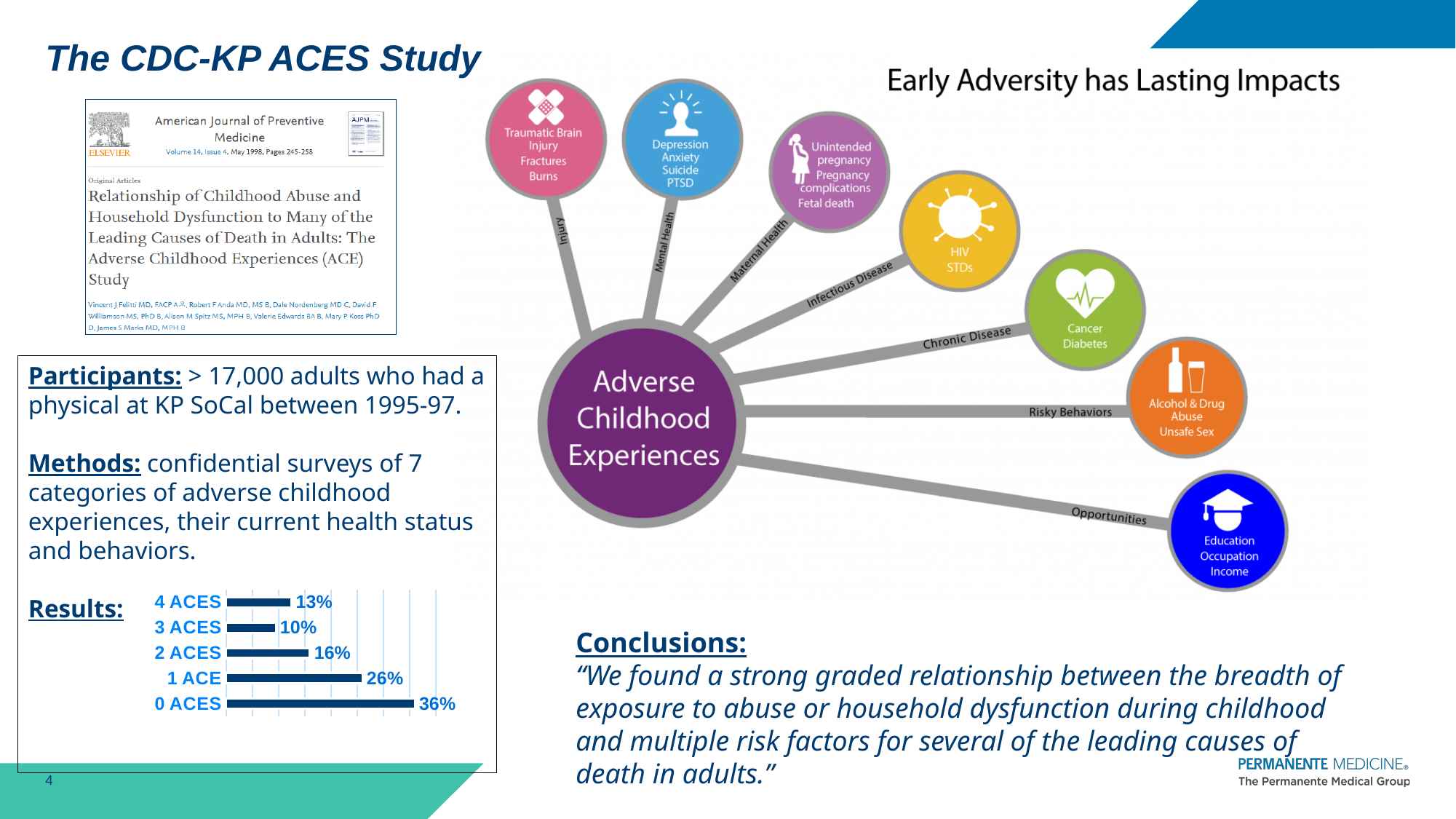
How many categories are shown in the Results bar chart? 5 Which category has the highest value in the Results bar chart? 0 ACES What kind of chart is used to show the Results? Bar chart What percentage of participants had 1 ACE in the Results bar chart? 26% What percentage of participants had 2 ACEs in the Results bar chart? 16% What percentage of participants had 3 ACEs in the Results bar chart? 10% In the Results bar chart, what is the difference between the values for 2 ACES and 3 ACES? 6% In the Results bar chart, which is larger: the value for 4 ACES or the value for 3 ACES? 4 ACES Which category has the lowest value in the Results bar chart? 3 ACES What percentage of participants had 0 ACEs in the Results bar chart? 36% What percentage of participants had 4 ACEs in the Results bar chart? 13% In the Results bar chart, what is the difference between the values for 0 ACES and 1 ACE? 10%